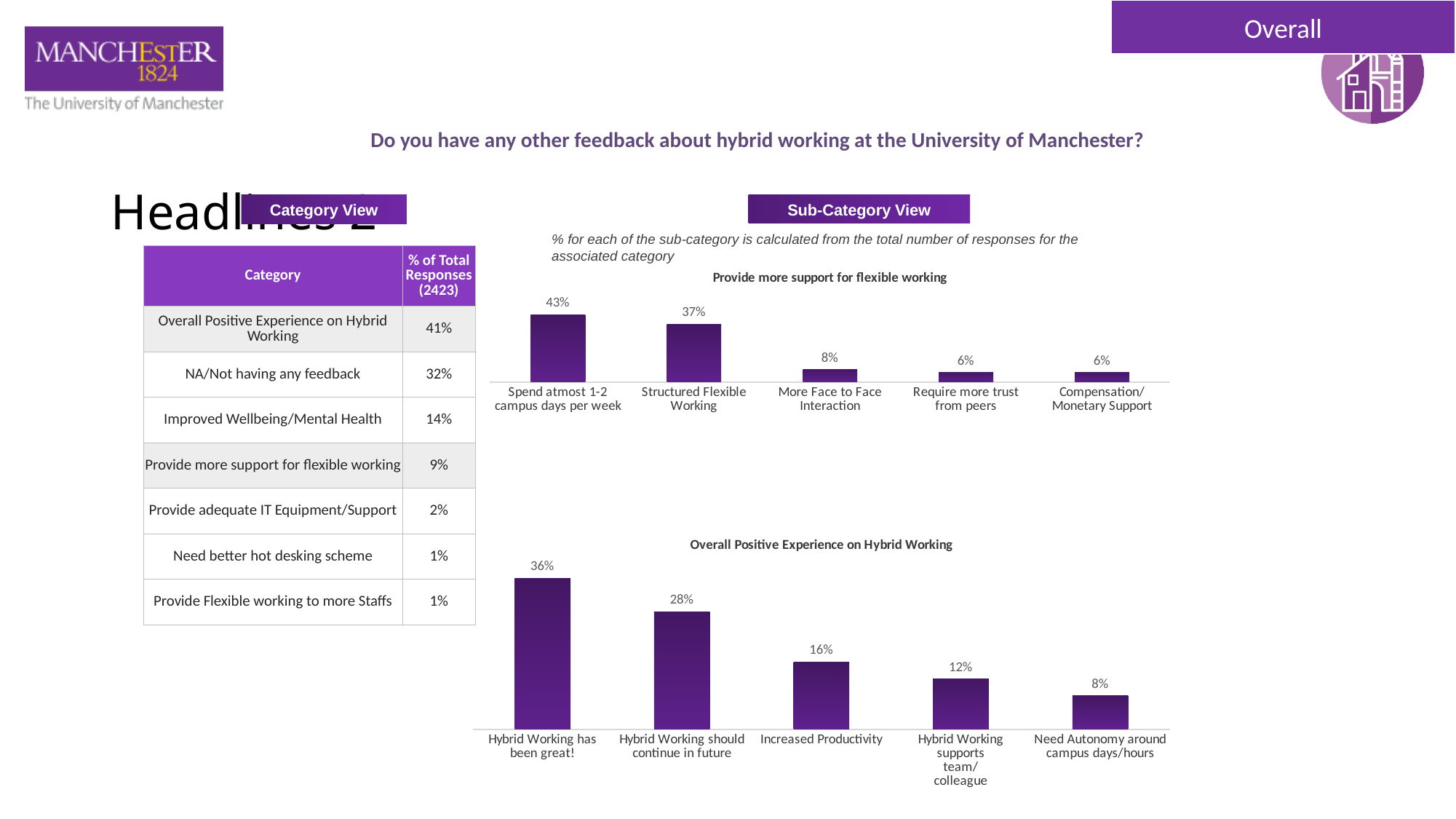
In the 'Provide more support for flexible working' chart, how many categories are plotted? 5 In the 'Provide more support for flexible working' chart, what is the difference between 'Spend atmost 1-2 campus days per week' and 'More Face to Face Interaction'? 35% In the 'Overall Positive Experience on Hybrid Working' chart, which category has the lowest value? Need Autonomy around campus days/hours In the 'Provide more support for flexible working' chart, what is the value for 'Structured Flexible Working'? 37% In the 'Provide more support for flexible working' chart, what is the value for 'Spend atmost 1-2 campus days per week'? 43% What type of chart is the 'Overall Positive Experience on Hybrid Working' chart? bar chart In the 'Provide more support for flexible working' chart, which category has the highest value? Spend atmost 1-2 campus days per week In the 'Overall Positive Experience on Hybrid Working' chart, which is larger: 'Hybrid Working has been great!' or 'Hybrid Working should continue in future'? Hybrid Working has been great! In the 'Overall Positive Experience on Hybrid Working' chart, what is the value for 'Increased Productivity'? 16% In the 'Overall Positive Experience on Hybrid Working' chart, what is the difference between 'Hybrid Working should continue in future' and 'Hybrid Working supports team/colleague'? 16% In the 'Overall Positive Experience on Hybrid Working' chart, do the values rise or fall from left to right? fall In the 'Overall Positive Experience on Hybrid Working' chart, what is the value for 'Need Autonomy around campus days/hours'? 8%